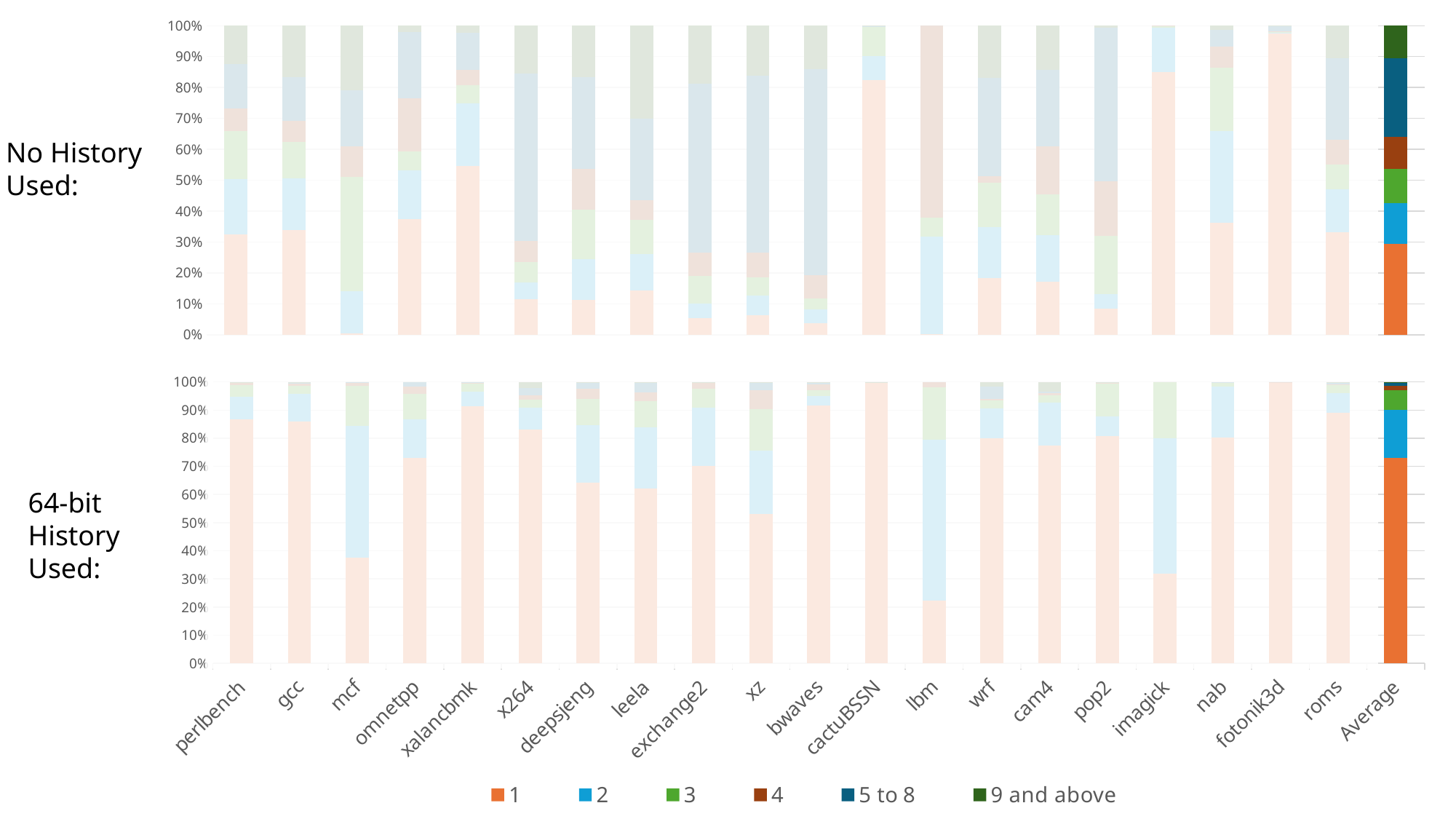
In the top chart (No History Used), is the value of series "1" for Average greater or less than 40%? less What is the last entry listed in the legend? 9 and above In the top chart (No History Used), is the value of series "1" for fotonik3d greater or less than 90%? greater How many series does the legend list? 6 In the bottom chart (64-bit History Used), which category has the lowest value for series "1"? lbm What kind of chart is the top chart labelled "No History Used"? stacked bar chart In the top chart (No History Used), which has the larger value for series "1", xalancbmk or gcc? xalancbmk How many categories are shown along the x axis of the bottom chart labelled "64-bit History Used"? 21 In the bottom chart (64-bit History Used), is the value of series "1" for mcf greater or less than 50%? less In the bottom chart (64-bit History Used), which has the larger value for series "1", perlbench or mcf? perlbench